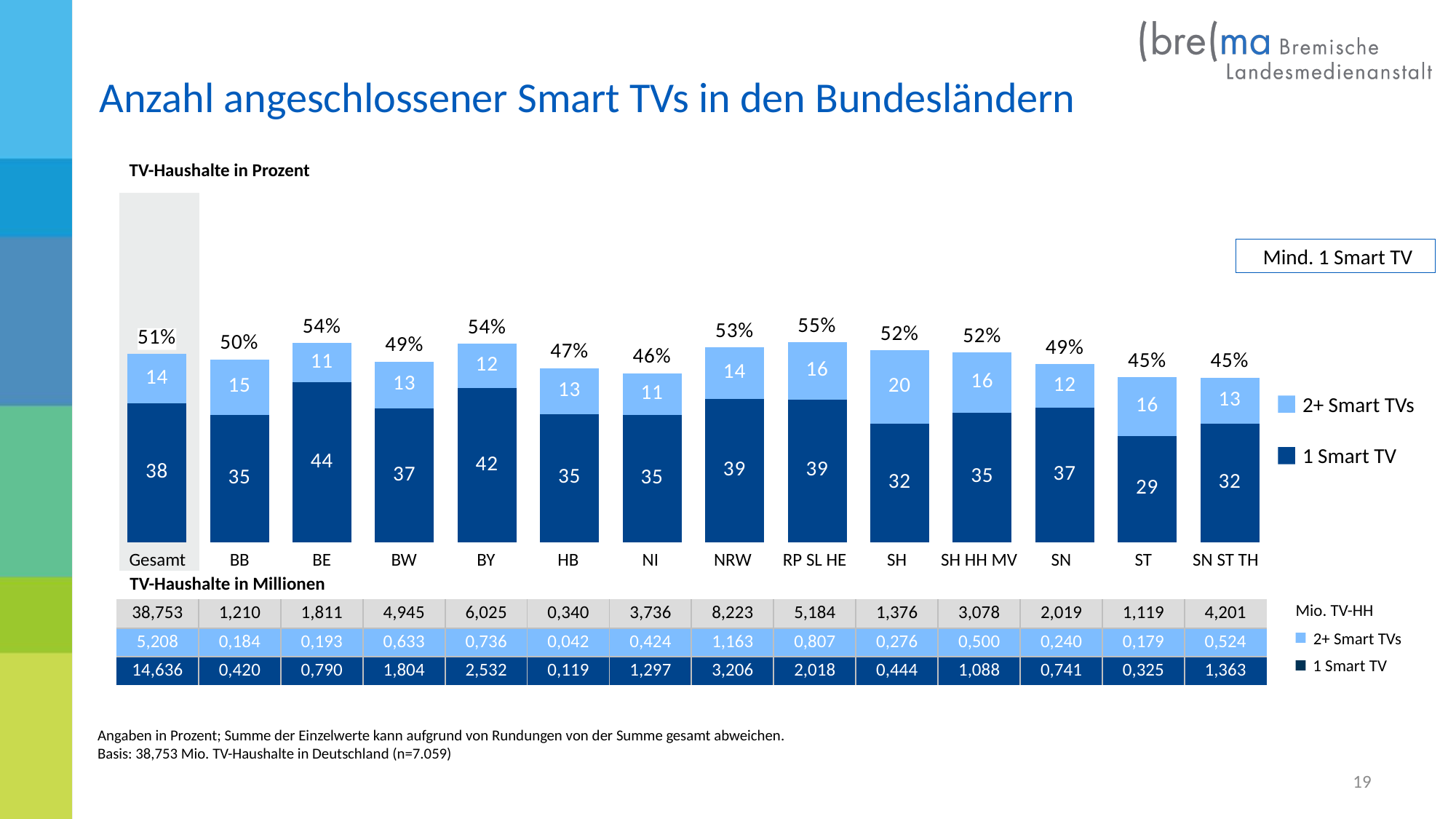
What is the difference between the 1 Smart TV values for BE and ST? 15 How many categories are shown on the x axis of the chart? 14 What kind of chart is shown on the slide? Stacked bar chart Which has the larger value for 2+ Smart TVs, BB or BW? BB What is the value for 2+ Smart TVs in SH? 20 Which category has the highest 'Mind. 1 Smart TV' total? RP SL HE What is the 'Mind. 1 Smart TV' total shown above the NRW bar? 53% What is the value for 1 Smart TV in BE? 44 Which category has the highest value for 2+ Smart TVs? SH How many series does the chart legend list? 2 What is the total shown above the Gesamt bar? 51% Which category has the lowest value for 1 Smart TV? ST